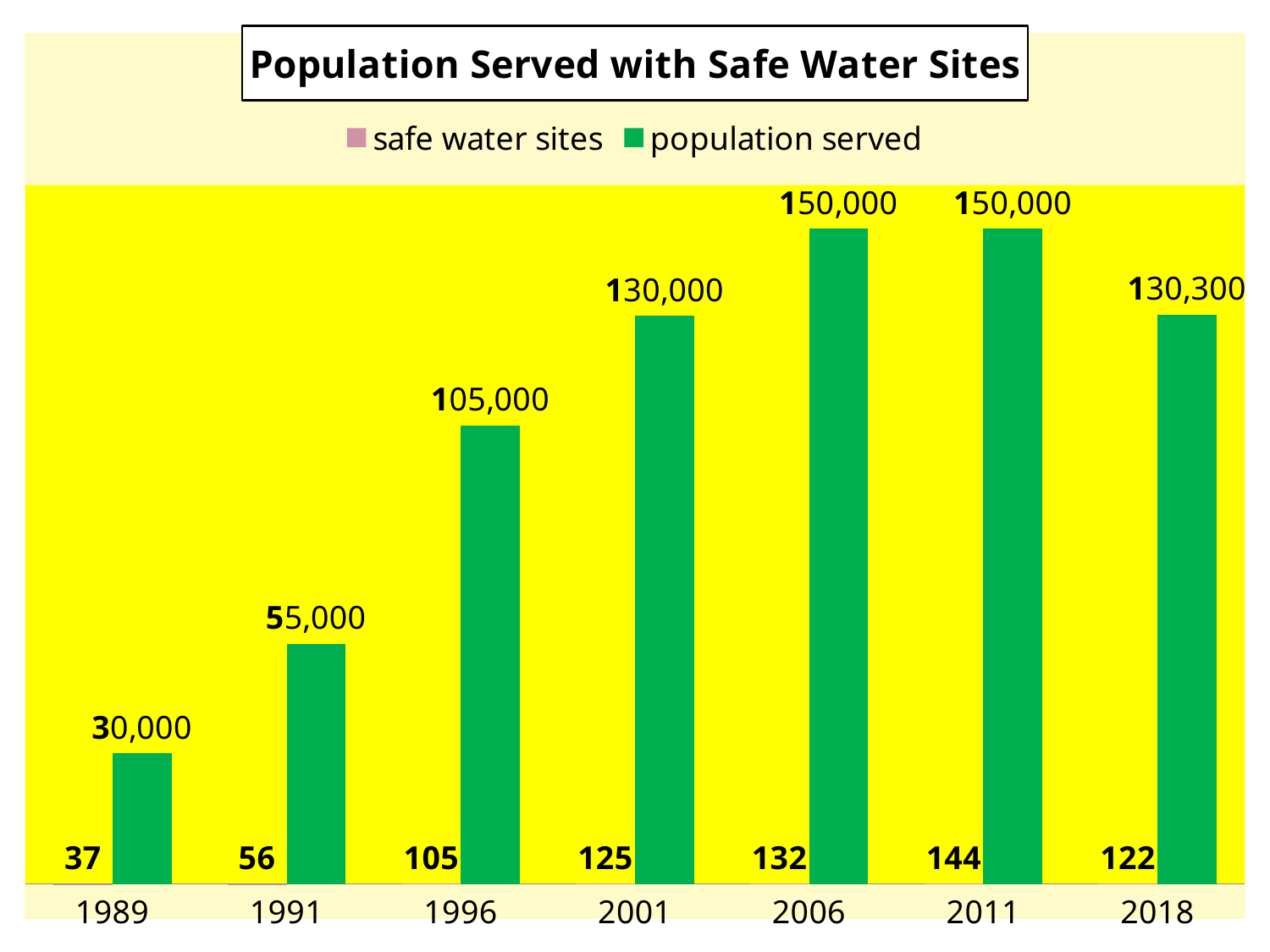
Which year has a larger population served, 2006 or 2018? 2006 How many series does the legend list? 2 How many safe water sites are shown for 1989? 37 What is the difference in population served between 2001 and 1991? 75,000 What is the difference in the number of safe water sites between 2011 and 2018? 22 Which year has the highest number of safe water sites? 2011 How many years are shown on the x axis? 7 What is the population served in 1996? 105,000 How many safe water sites are shown for 2011? 144 Which year has the lowest population served? 1989 What is the title of the chart? Population Served with Safe Water Sites What is the population served in 2018? 130,300